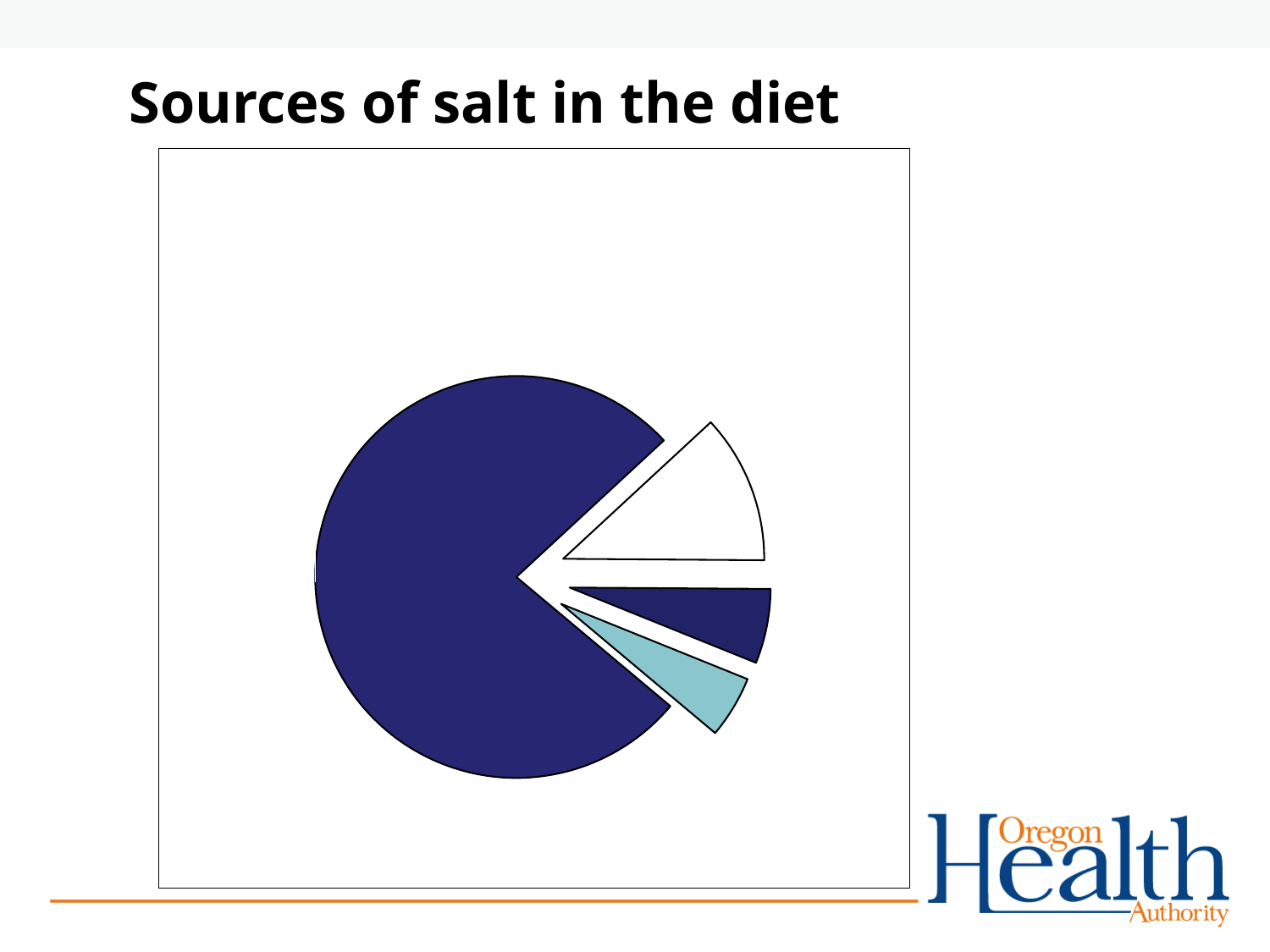
How many slices does the pie chart have? 4 Does the largest slice of the pie chart take up more or less than half of the pie? more Which slice of the pie chart is the largest: the dark blue slice, the white slice, or the light blue slice? the dark blue slice What kind of chart is shown on the slide? pie chart What is the title shown above the pie chart? Sources of salt in the diet Does the pie chart show a legend? No Which is larger in the pie chart, the white slice or the light blue slice? the white slice